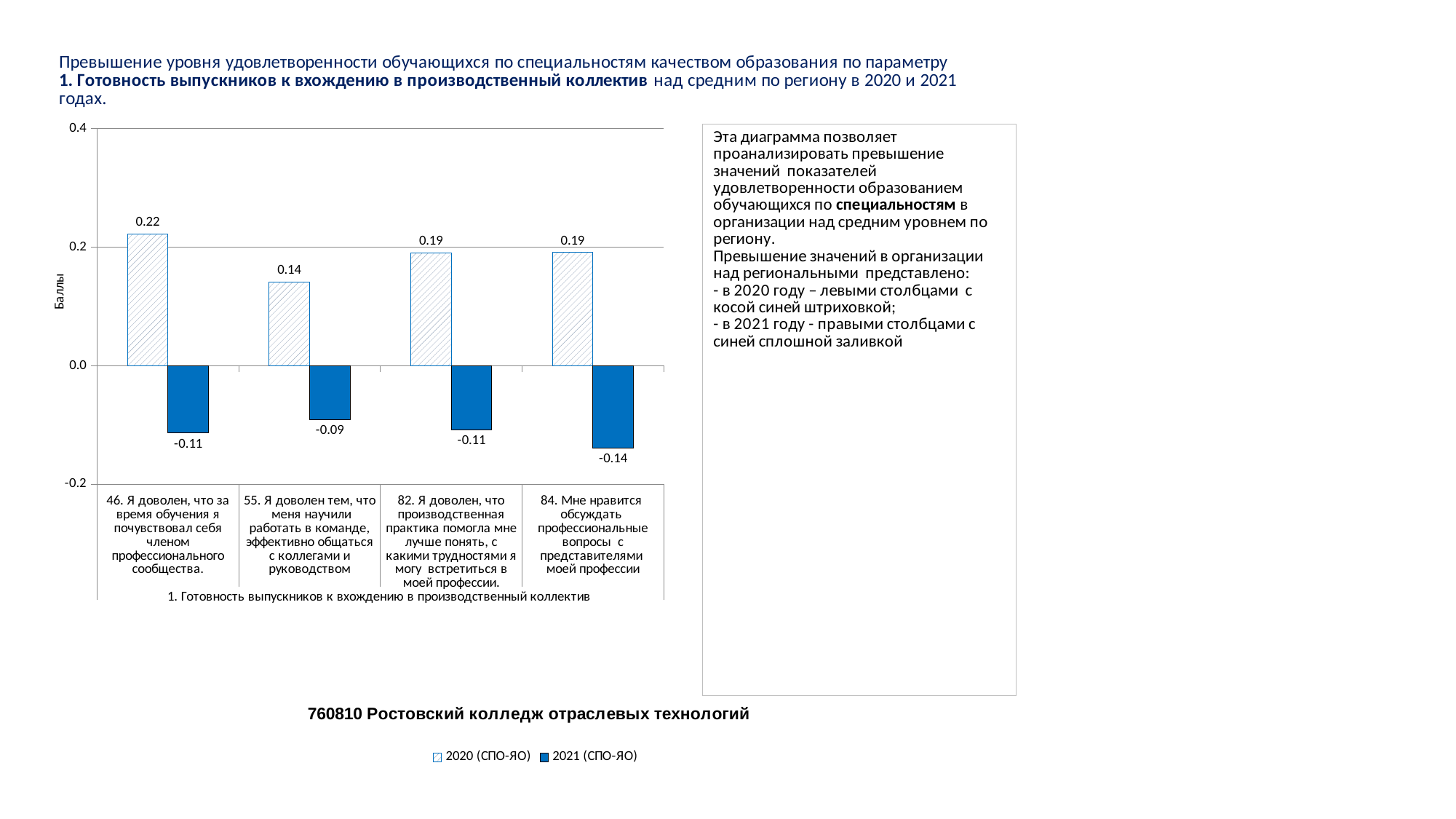
How many categories are shown on the x axis? 4 Which category has the highest 2020 (СПО-ЯО) value? 46. Я доволен, что за время обучения я почувствовал себя членом профессионального сообщества. Which category has the lowest 2021 (СПО-ЯО) value? 84. Мне нравится обсуждать профессиональные вопросы с представителями моей профессии What is the 2020 (СПО-ЯО) value for category 46 (Я доволен, что за время обучения я почувствовал себя членом профессионального сообщества)? 0.22 What kind of chart is shown on the slide? Bar chart What is the 2021 (СПО-ЯО) value for category 84 (Мне нравится обсуждать профессиональные вопросы с представителями моей профессии)? -0.14 What is the label of the y axis? Баллы How many series does the legend list? 2 Which is larger: the 2020 value for category 55 or the 2020 value for category 82? Category 82 (0.19) What is the difference between the 2020 and 2021 values for category 46? 0.33 What is the 2020 (СПО-ЯО) value for category 55 (Я доволен тем, что меня научили работать в команде)? 0.14 What is the 2021 (СПО-ЯО) value for category 82 (Я доволен, что производственная практика помогла мне лучше понять...)? -0.11